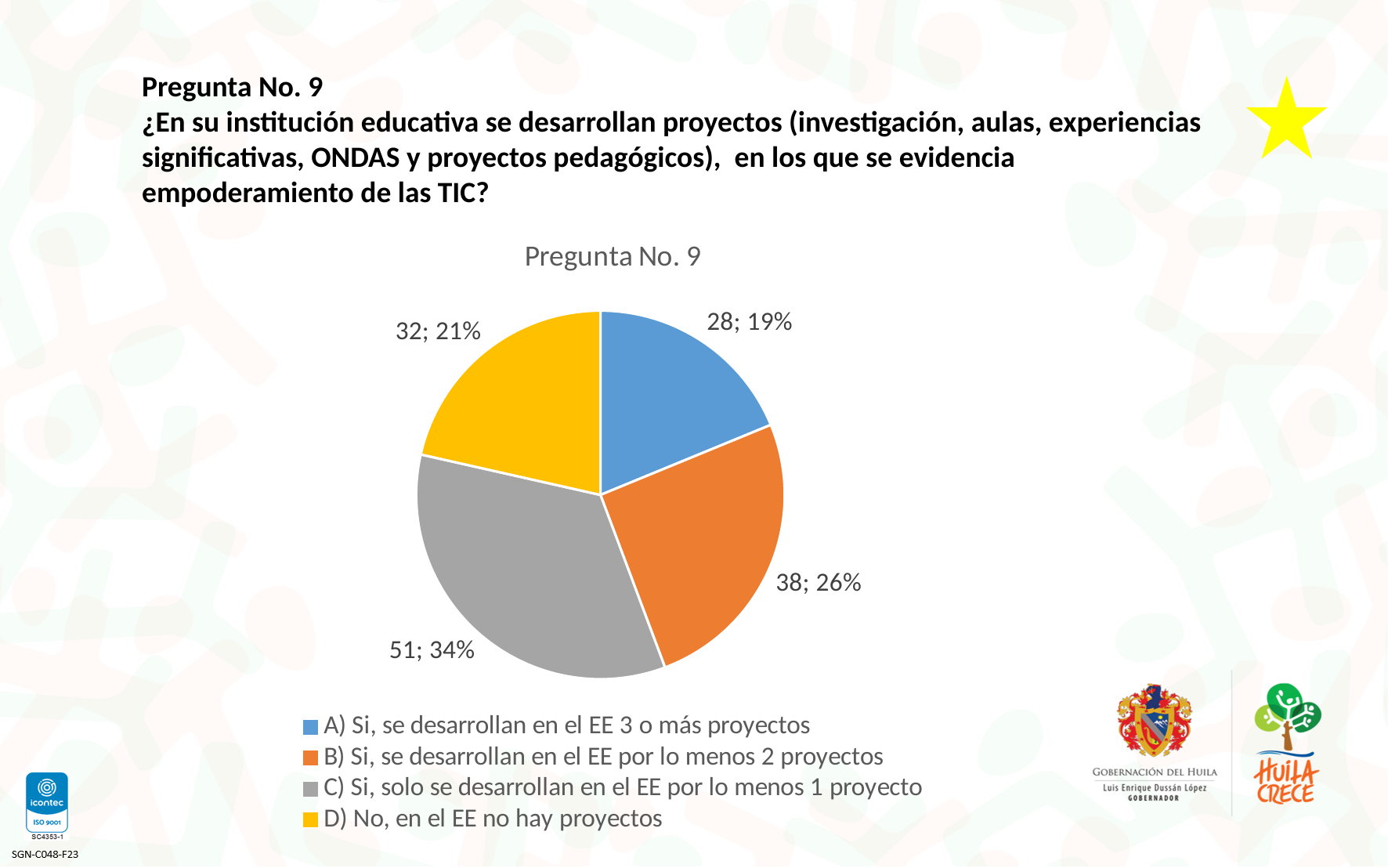
What is the count for 'A) Si, se desarrollan en el EE 3 o más proyectos'? 28 Which category has the largest slice? C) Si, solo se desarrollan en el EE por lo menos 1 proyecto What percentage share does 'B) Si, se desarrollan en el EE por lo menos 2 proyectos' have? 26% What is the title of the chart? Pregunta No. 9 How many slices does the pie chart have? 4 Which is larger, the count for category B or the count for category D? B) Si, se desarrollan en el EE por lo menos 2 proyectos How many entries does the legend list? 4 What is the difference in count between category C and category A? 23 What percentage share does 'D) No, en el EE no hay proyectos' have? 21% Which category has the smallest slice? A) Si, se desarrollan en el EE 3 o más proyectos What is the count for 'C) Si, solo se desarrollan en el EE por lo menos 1 proyecto'? 51 What kind of chart is shown on the slide? pie chart